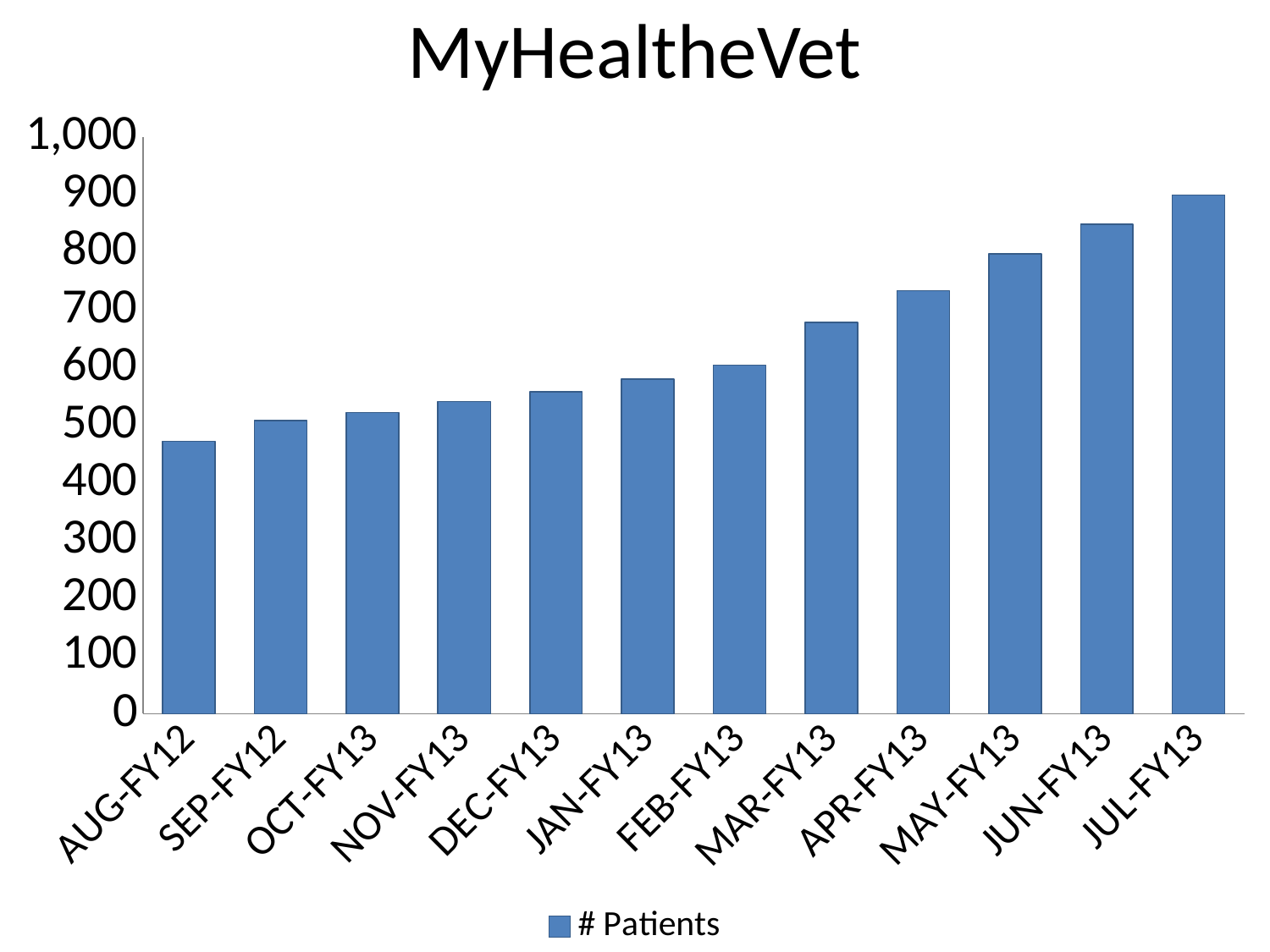
Is the value for AUG-FY12 greater or less than 500? less How many months are plotted on the x axis? 12 What kind of chart is shown on the slide? bar chart How many series does the legend list? 1 Which month has the lowest number of patients? AUG-FY12 Do the values rise or fall from AUG-FY12 to JUL-FY13? rise Is the value for APR-FY13 greater or less than 700? greater What is the title of the chart? MyHealtheVet Which is larger, the value for MAR-FY13 or the value for DEC-FY13? MAR-FY13 What is the name of the series shown in the legend? # Patients Is the value for JUN-FY13 greater or less than 800? greater Which month has the highest number of patients? JUL-FY13